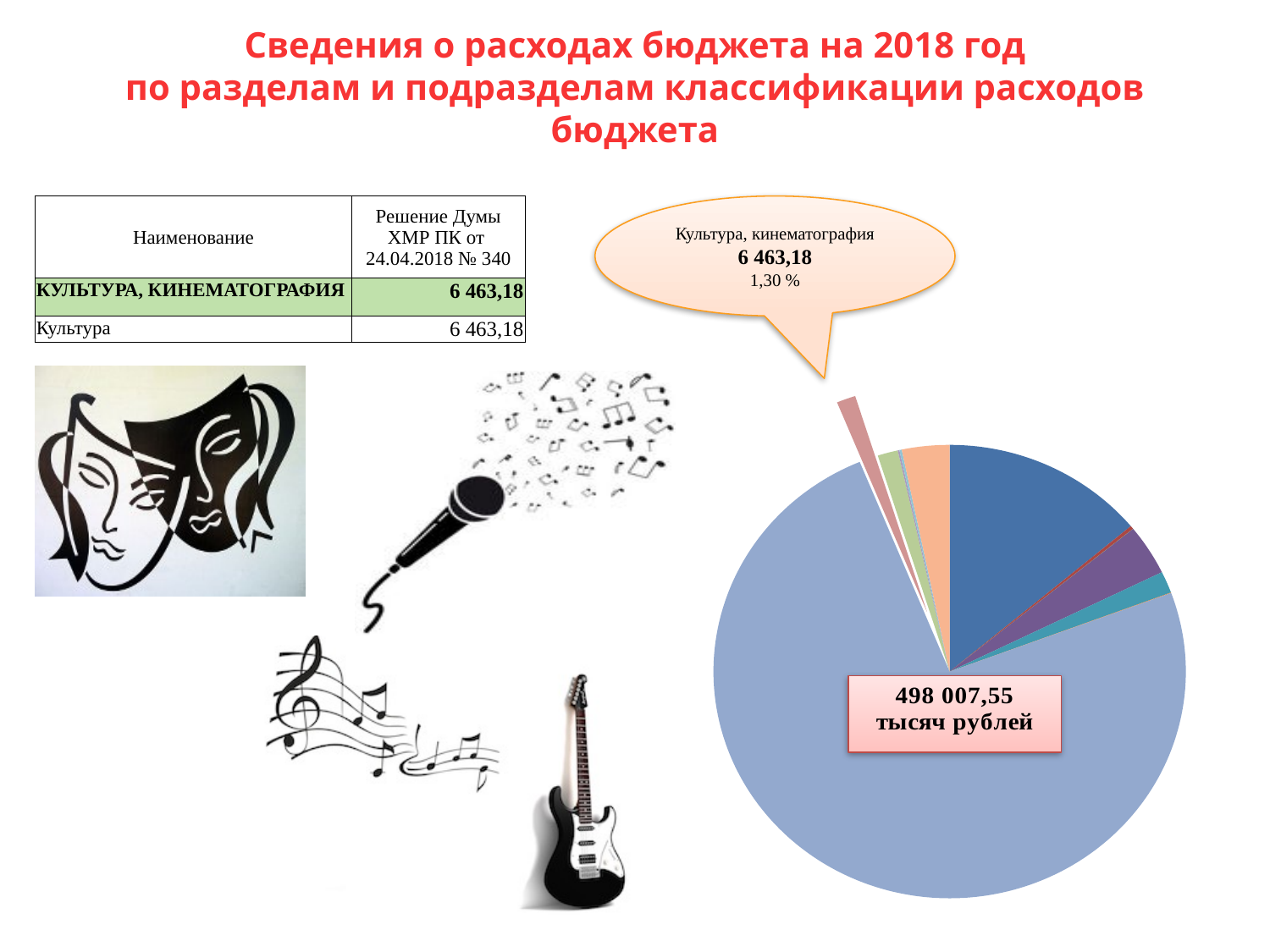
Does the Культура, кинематография slice make up more or less than half of the pie? less What total is printed in the box on the pie chart? 498 007,55 тысяч рублей What kind of chart is shown on the slide? pie chart What value does the callout give for the Культура, кинематография slice of the pie chart? 6 463,18 What share of the pie does the Культура, кинематография slice represent, according to the callout? 1,30 % Is the exploded slice of the pie chart pulled out from the rest of the pie? yes Is the Культура, кинематография slice the largest slice of the pie chart? no Which category is named in the callout pointing to the exploded slice of the pie chart? Культура, кинематография